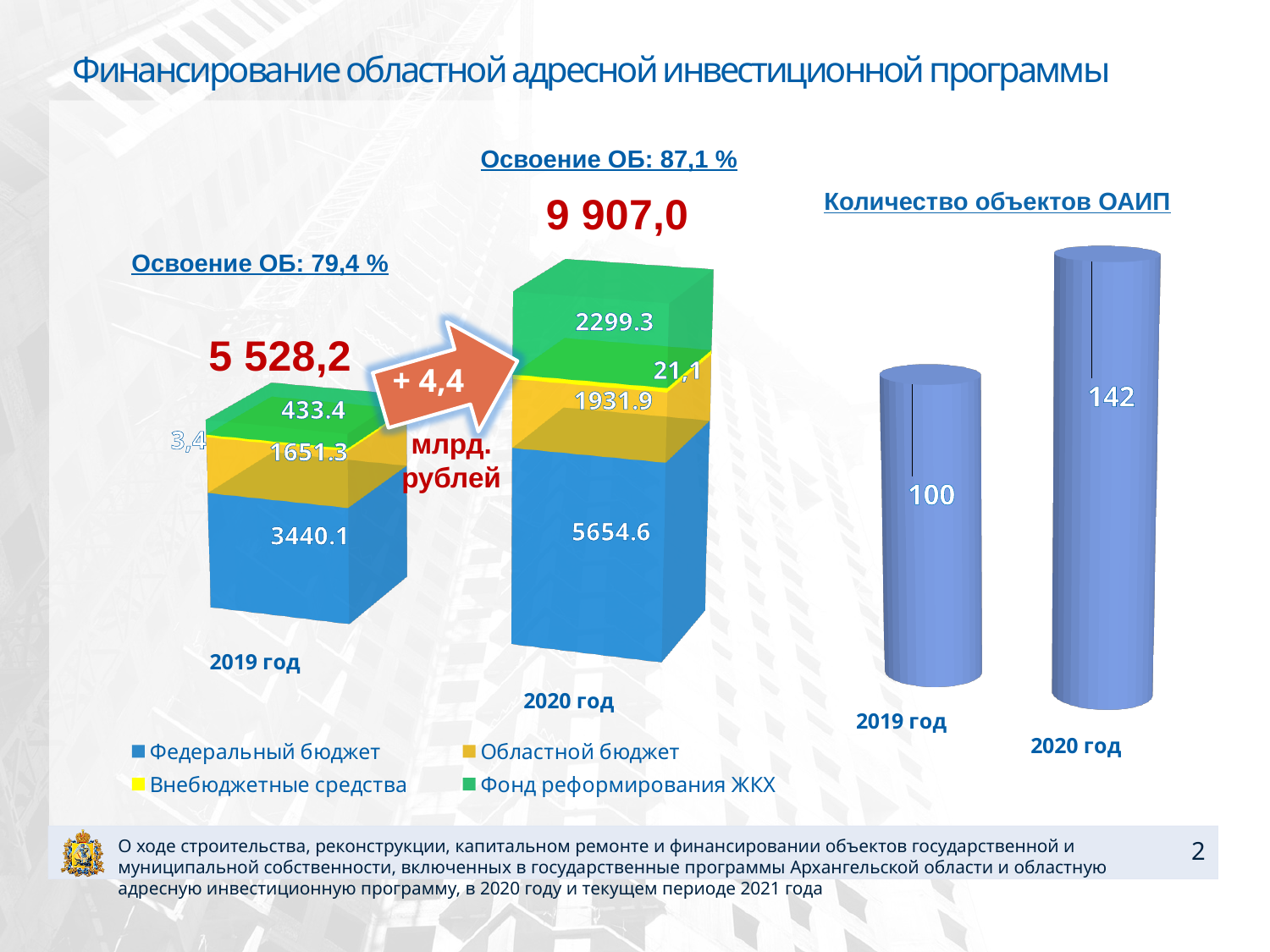
In the left stacked bar chart, what is the value for Фонд реформирования ЖКХ in 2020 год? 2299.3 In the left stacked bar chart, what is the total shown above the 2020 год bar? 9 907,0 In the left stacked bar chart, what is the difference between the Федеральный бюджет values for 2020 год and 2019 год? 2214.5 In the chart titled Количество объектов ОАИП, what is the difference between 2020 год and 2019 год? 42 In the chart titled Количество объектов ОАИП, what is the value for 2020 год? 142 In the left stacked bar chart, how many series does the legend list? 4 In the left stacked bar chart, what is the total shown above the 2019 год bar? 5 528,2 In the left stacked bar chart, what is the value for Федеральный бюджет in 2020 год? 5654.6 In the chart titled Количество объектов ОАИП, which year has the higher value? 2020 год In the left stacked bar chart, which series is shown in green? Фонд реформирования ЖКХ In the left stacked bar chart, what is the value for Областной бюджет in 2019 год? 1651.3